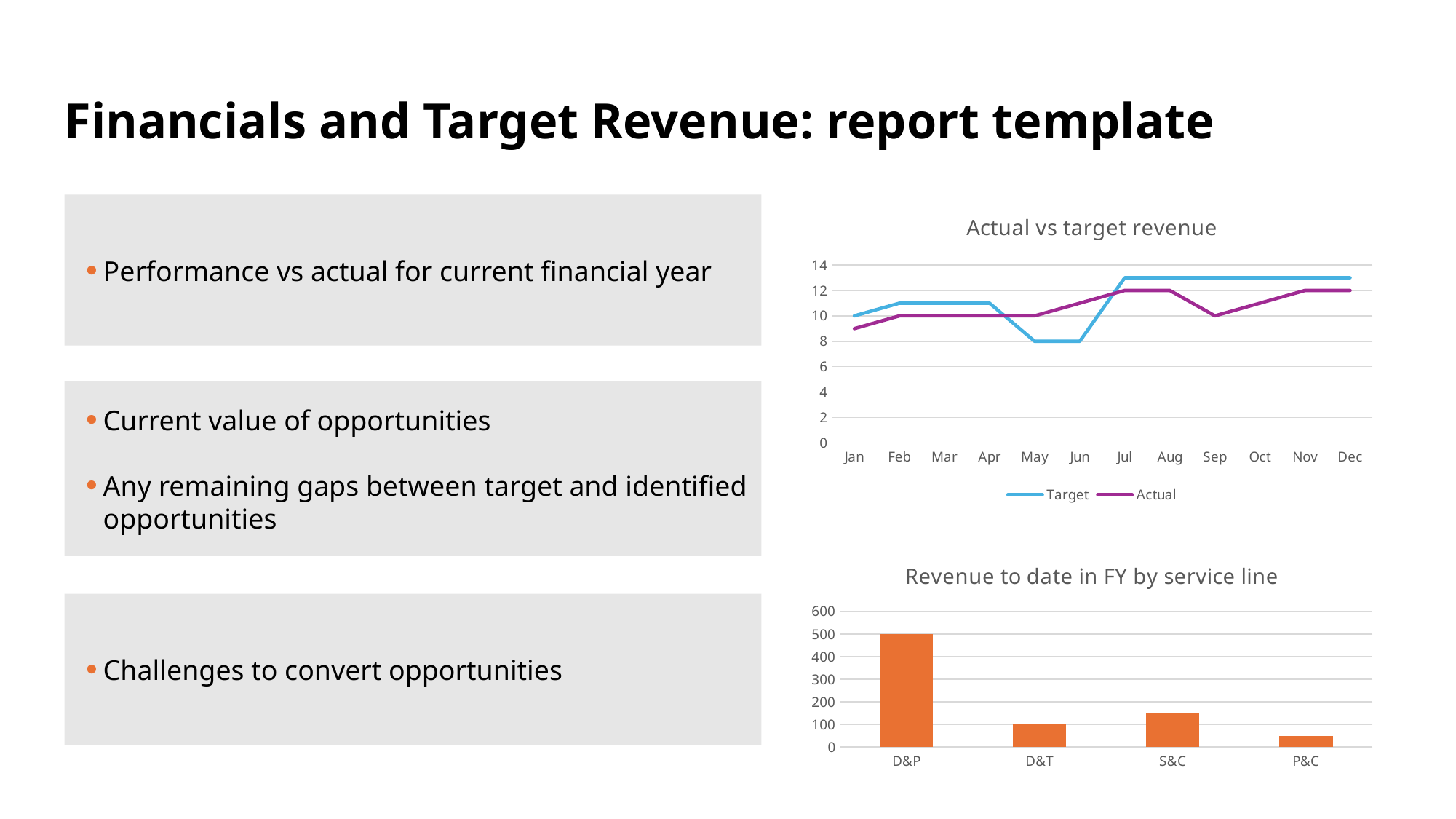
In the 'Actual vs target revenue' chart, is the Target value for Dec greater or less than 12? greater In the 'Revenue to date in FY by service line' chart, what is the value for D&P? 500 In the 'Revenue to date in FY by service line' chart, which service line has the lowest revenue? P&C In the 'Actual vs target revenue' chart, what is the Actual value for Sep? 10 What kind of chart is 'Revenue to date in FY by service line'? bar chart How many series does the legend of the 'Actual vs target revenue' chart list? 2 In the 'Actual vs target revenue' chart, which series is higher in Jun, Target or Actual? Actual In the 'Revenue to date in FY by service line' chart, which service line has the highest revenue? D&P In the 'Revenue to date in FY by service line' chart, is the value for S&C greater or less than 100? greater In the 'Actual vs target revenue' chart, what is the Target value for May? 8 How many months are shown on the x axis of the 'Actual vs target revenue' chart? 12 What kind of chart is 'Actual vs target revenue'? line chart